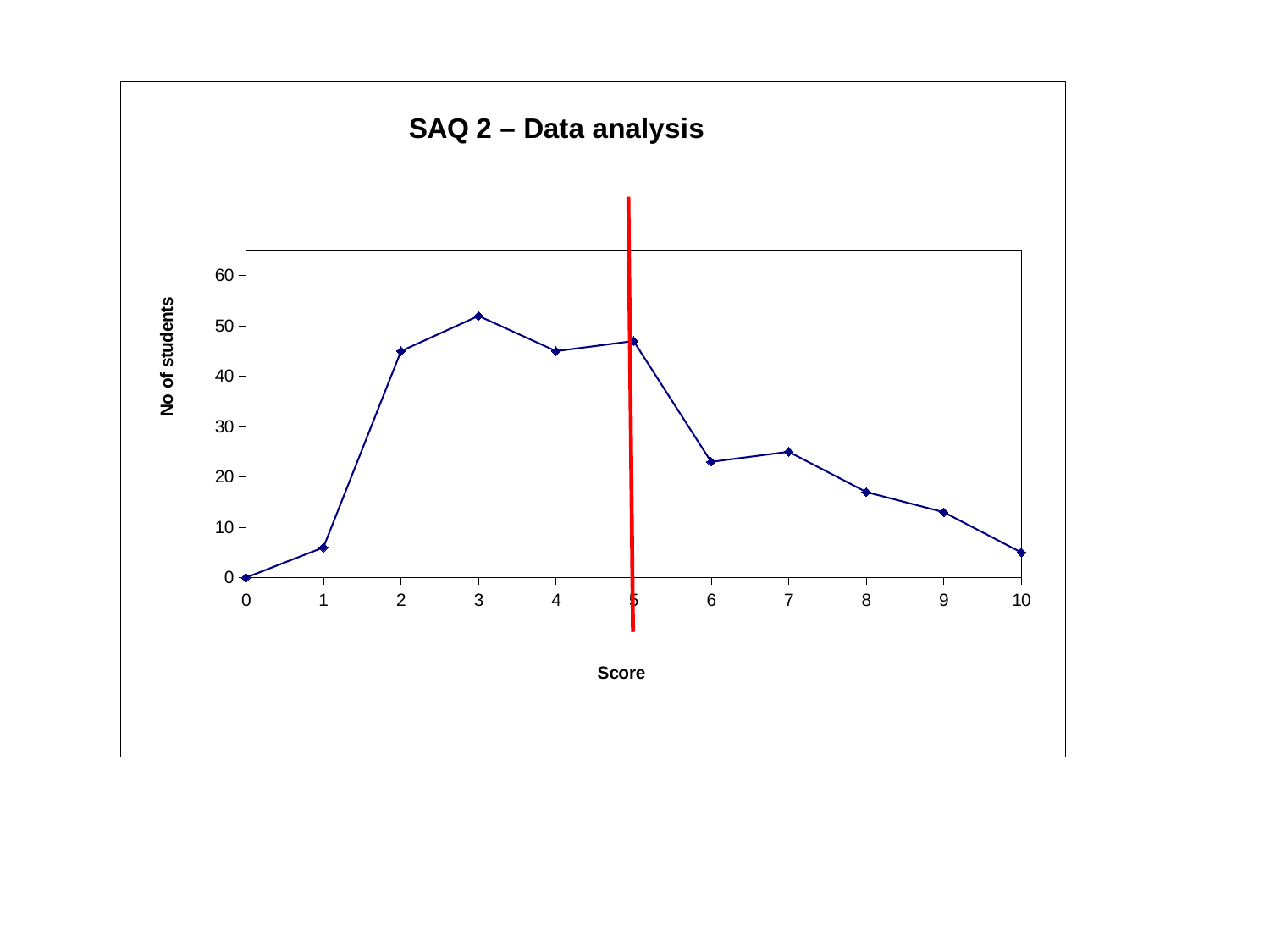
What kind of chart is shown on the slide? line chart Which has more students, score 2 or score 7? score 2 Is the number of students at score 2 greater or less than 40? greater How many data points are plotted on the line? 11 What is the label of the vertical axis? No of students At which score is the number of students lowest? 0 Is the number of students at score 10 greater or less than 10? less Do the values rise or fall as the score goes from 5 to 10? fall At which score is the number of students highest? 3 Is the number of students at score 6 greater or less than 30? less What is the number of students at score 0? 0 What is the title of the chart? SAQ 2 – Data analysis